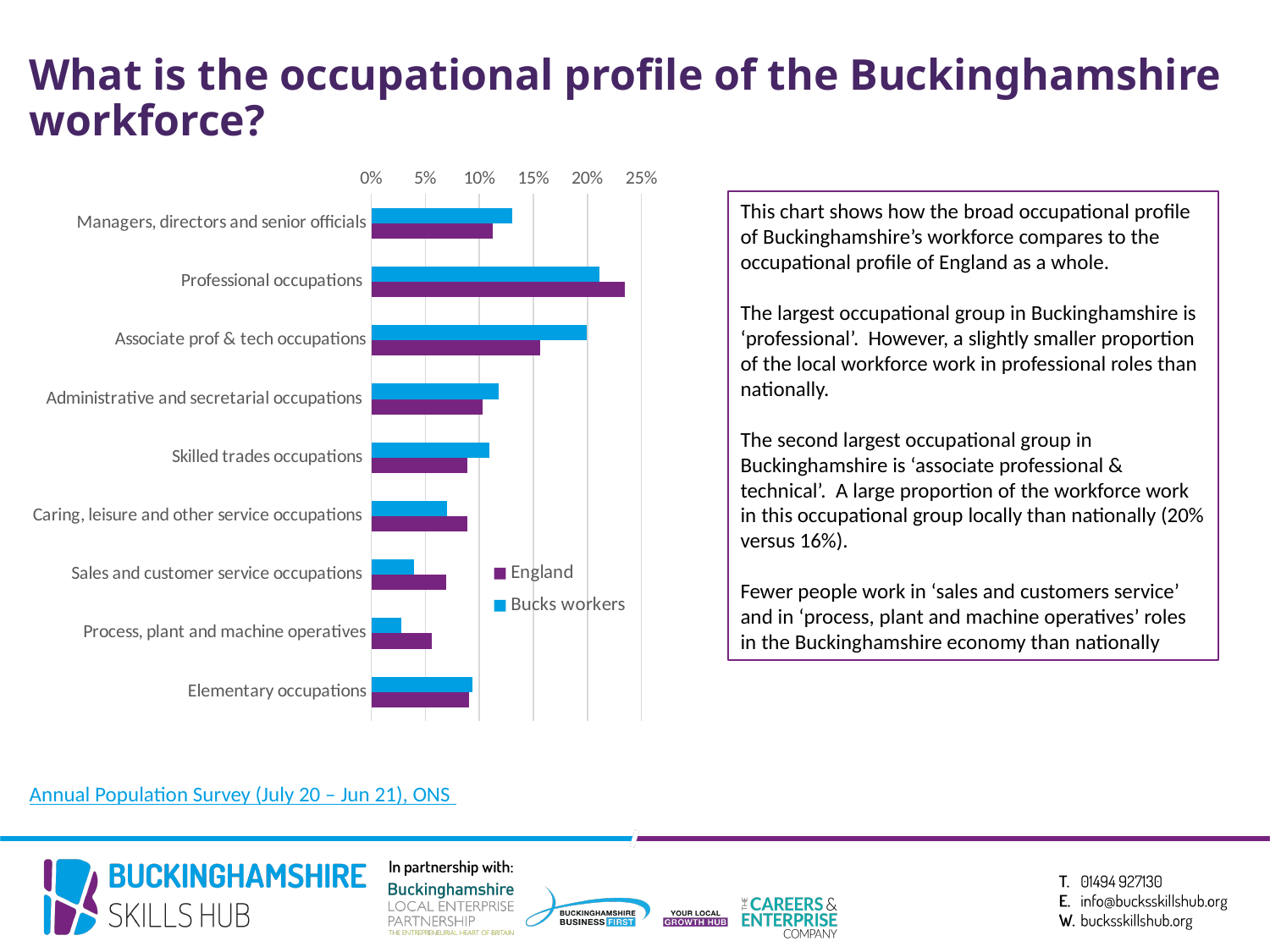
Is the England value for Process, plant and machine operatives greater or less than 10%? less How many series does the chart legend list? 2 Which occupational category has the highest value for Bucks workers? Professional occupations Is the Bucks workers value for Sales and customer service occupations greater or less than 5%? less Which occupational category has the lowest value for Bucks workers? Process, plant and machine operatives Is the Bucks workers value for Associate prof & tech occupations greater or less than 15%? greater For Professional occupations, which series has the larger value, England or Bucks workers? England For Associate prof & tech occupations, which series has the larger value, England or Bucks workers? Bucks workers Which colour represents the England series in the chart? Purple Which occupational category has the highest value for England? Professional occupations What kind of chart is shown on the slide? Bar chart How many occupational categories are plotted on the chart? 9